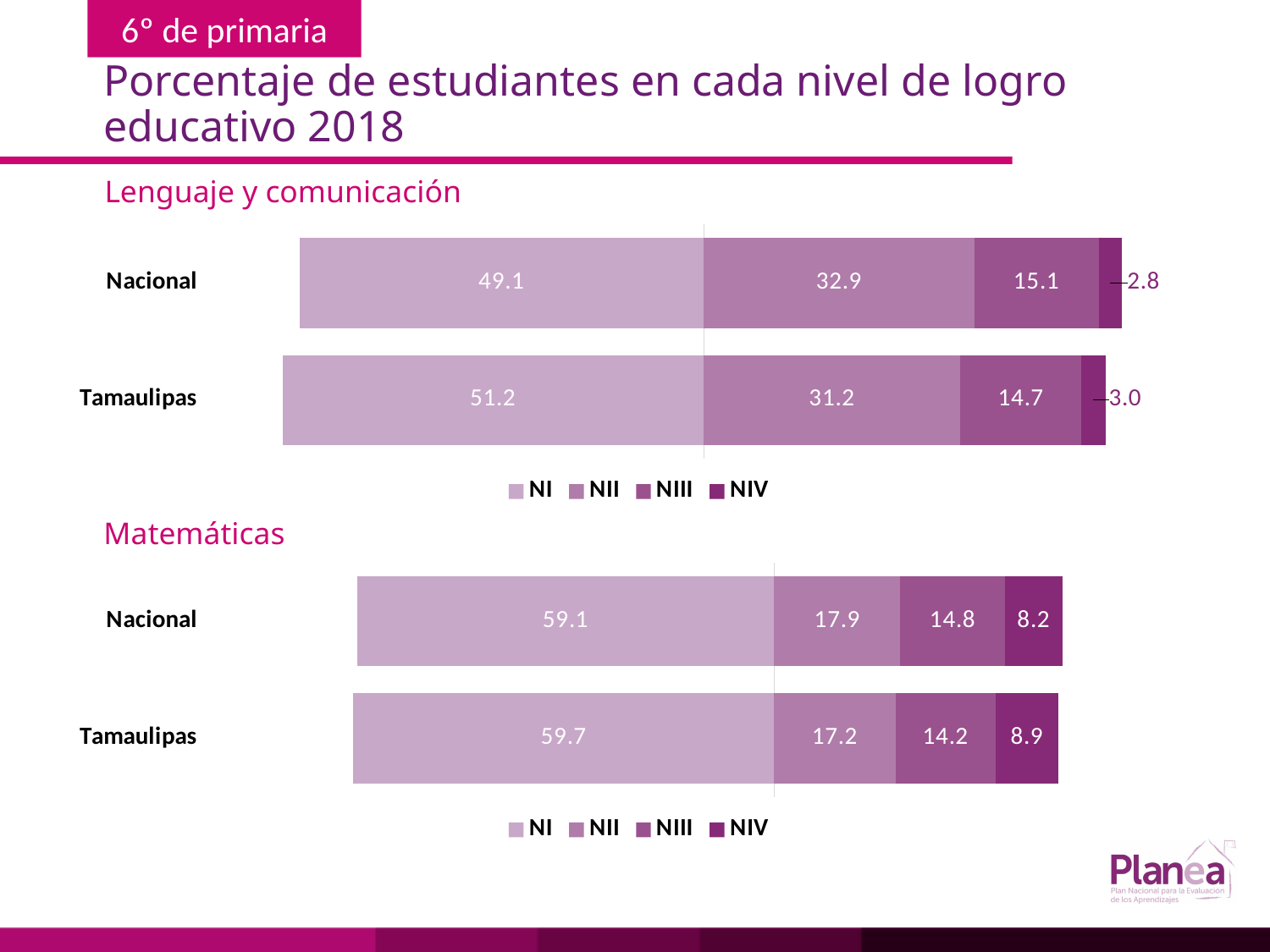
In the Lenguaje y comunicación chart, what is the NI value for Nacional? 49.1 In the Lenguaje y comunicación chart, which level has the highest value for Nacional? NI In the Matemáticas chart, what is the NIV value for Nacional? 8.2 In the Lenguaje y comunicación chart, what is the difference between the NI values for Tamaulipas and Nacional? 2.1 In the Matemáticas chart, what is the difference between the NIII values for Nacional and Tamaulipas? 0.6 In the Matemáticas chart, what is the total of the stacked bar for Nacional? 100.0 In the Matemáticas chart, which has the larger NIV value, Nacional or Tamaulipas? Tamaulipas In the Lenguaje y comunicación chart, what is the NIV value for Tamaulipas? 3.0 In the Matemáticas chart, what is the NII value for Tamaulipas? 17.2 In the Matemáticas chart, which level has the lowest value for Tamaulipas? NIV What type of chart is the Matemáticas chart? Stacked bar chart How many series does the legend of the Lenguaje y comunicación chart list? 4